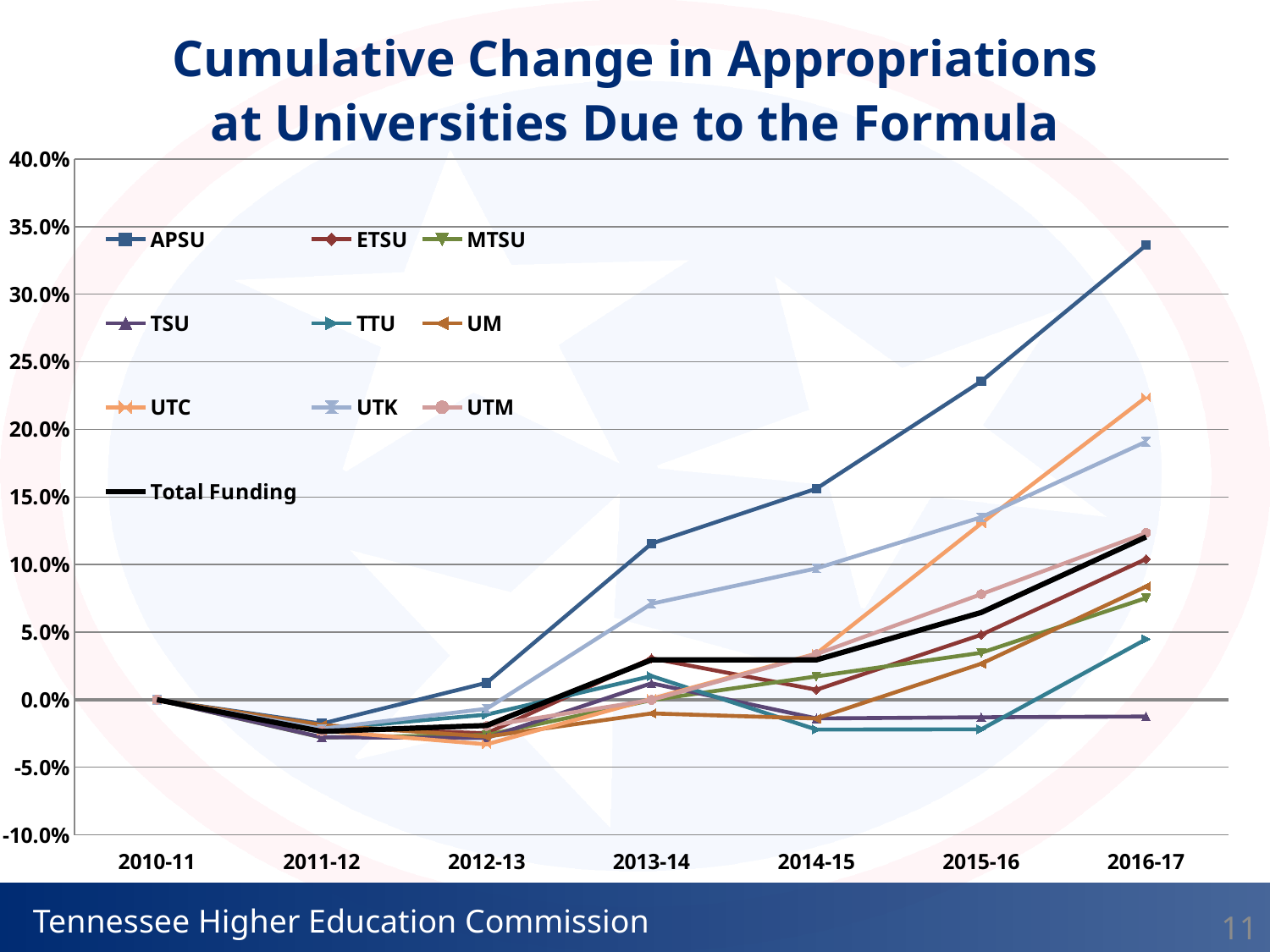
In 2014-15, which is larger, the value for APSU or the value for UTK? APSU What kind of chart is shown on the slide? line chart Is the value for APSU in 2016-17 greater or less than 30.0%? greater Which university has the highest cumulative change in 2016-17? APSU In 2016-17, which is larger, the value for UTC or the value for UTK? UTC Is the value for TTU in 2015-16 greater or less than 0.0%? less Which series has the lowest value in 2016-17? TSU How many academic years are shown along the x axis? 7 How many series does the legend list? 10 Is the value for UTC in 2016-17 greater or less than 20.0%? greater Does the APSU line rise or fall from 2013-14 to 2016-17? rise